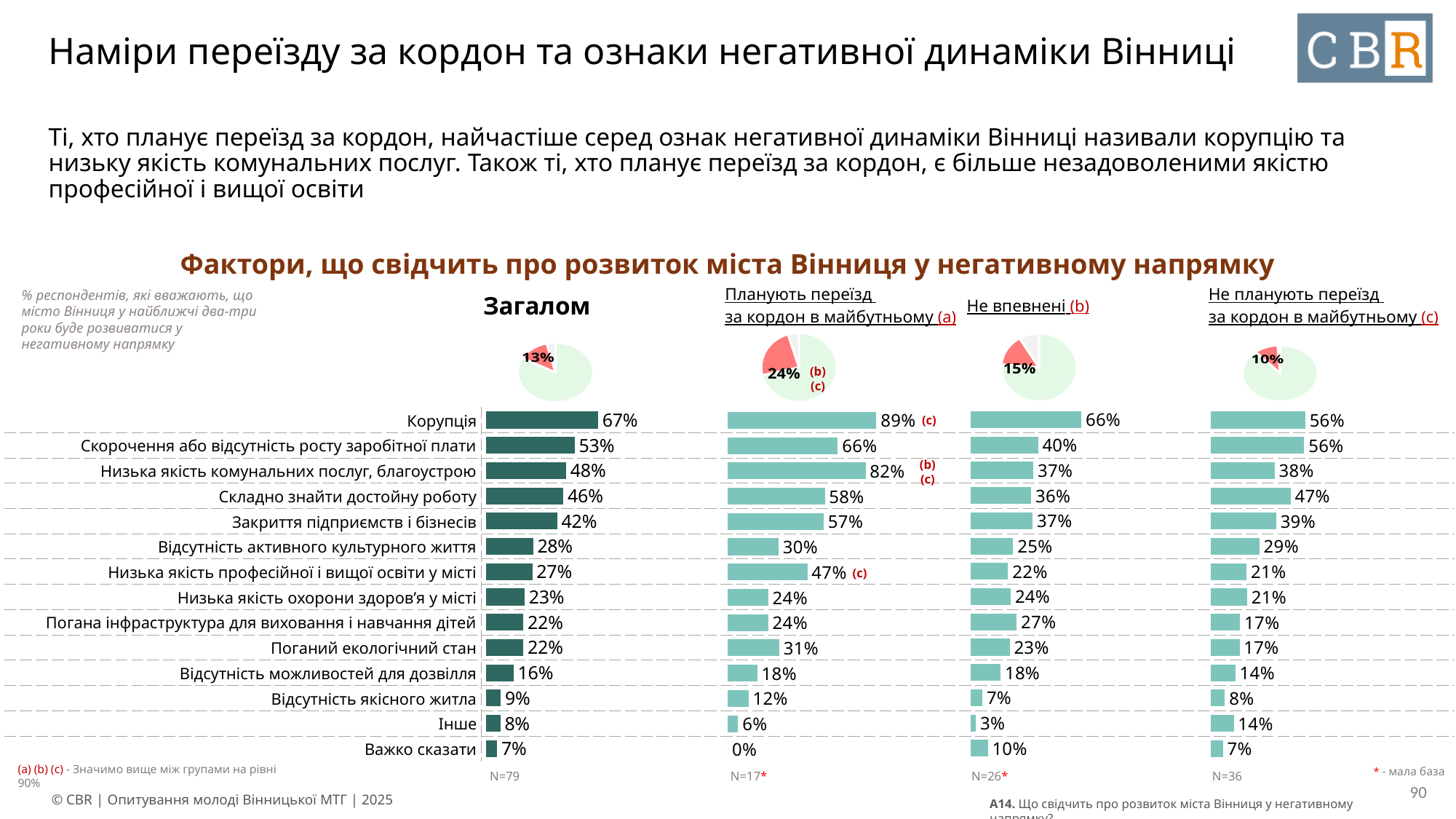
In the 'Планують переїзд за кордон в майбутньому (a)' chart, what is the value for 'Низька якість комунальних послуг, благоустрою'? 82% What is the sample size (N) shown under the 'Не планують переїзд за кордон в майбутньому (c)' chart? N=36 In the 'Загалом' chart, what is the value for 'Корупція'? 67% What percentage is shown in the small pie chart above the 'Планують переїзд за кордон в майбутньому (a)' chart? 24% What type of chart is used to show the factors in the 'Загалом' section? Bar chart How many categories are listed in the 'Загалом' chart? 14 In the 'Загалом' chart, what is the difference between 'Корупція' and 'Скорочення або відсутність росту заробітної плати'? 14 percentage points In the 'Не впевнені (b)' chart, what is the value for 'Скорочення або відсутність росту заробітної плати'? 40% In the 'Не впевнені (b)' chart, which category has the lowest value? Інше In the 'Планують переїзд за кордон в майбутньому (a)' chart, which category has the highest value? Корупція For 'Низька якість професійної і вищої освіти у місті', which is larger: the value in the 'Планують переїзд за кордон в майбутньому (a)' chart or in the 'Не планують переїзд за кордон в майбутньому (c)' chart? Планують переїзд за кордон в майбутньому (a) In the 'Не планують переїзд за кордон в майбутньому (c)' chart, what is the value for 'Складно знайти достойну роботу'? 47%